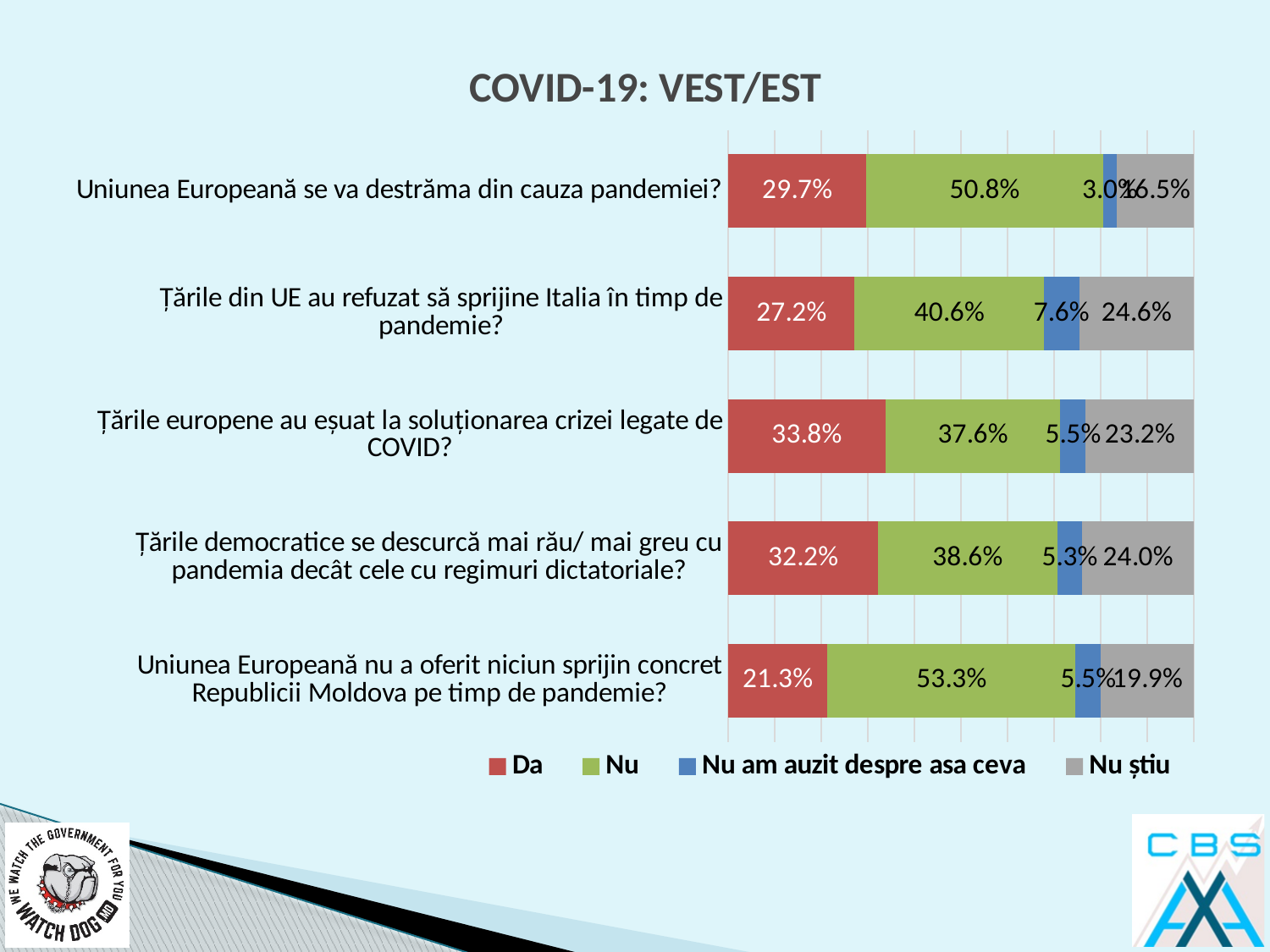
What is the 'Nu știu' value for 'Țările din UE au refuzat să sprijine Italia în timp de pandemie?' 24.6% Which statement has the lowest 'Da' value? Uniunea Europeană nu a oferit niciun sprijin concret Republicii Moldova pe timp de pandemie? What is the title of the chart? COVID-19: VEST/EST How many series does the legend list? 4 How many statements (categories) are shown in the chart? 5 What is the difference between the 'Nu' and 'Da' values for 'Țările din UE au refuzat să sprijine Italia în timp de pandemie?' 13.4% What is the 'Da' value for 'Țările europene au eșuat la soluționarea crizei legate de COVID?' 33.8% What is the 'Nu am auzit despre asa ceva' value for 'Țările democratice se descurcă mai rău/ mai greu cu pandemia decât cele cu regimuri dictatoriale?' 5.3% What is the 'Nu' value for 'Uniunea Europeană nu a oferit niciun sprijin concret Republicii Moldova pe timp de pandemie?' 53.3% Which is larger for 'Țările democratice se descurcă mai rău/ mai greu cu pandemia decât cele cu regimuri dictatoriale?': the 'Da' value or the 'Nu' value? Nu What type of chart is shown on the slide? stacked bar chart Which statement has the highest 'Da' value? Țările europene au eșuat la soluționarea crizei legate de COVID?